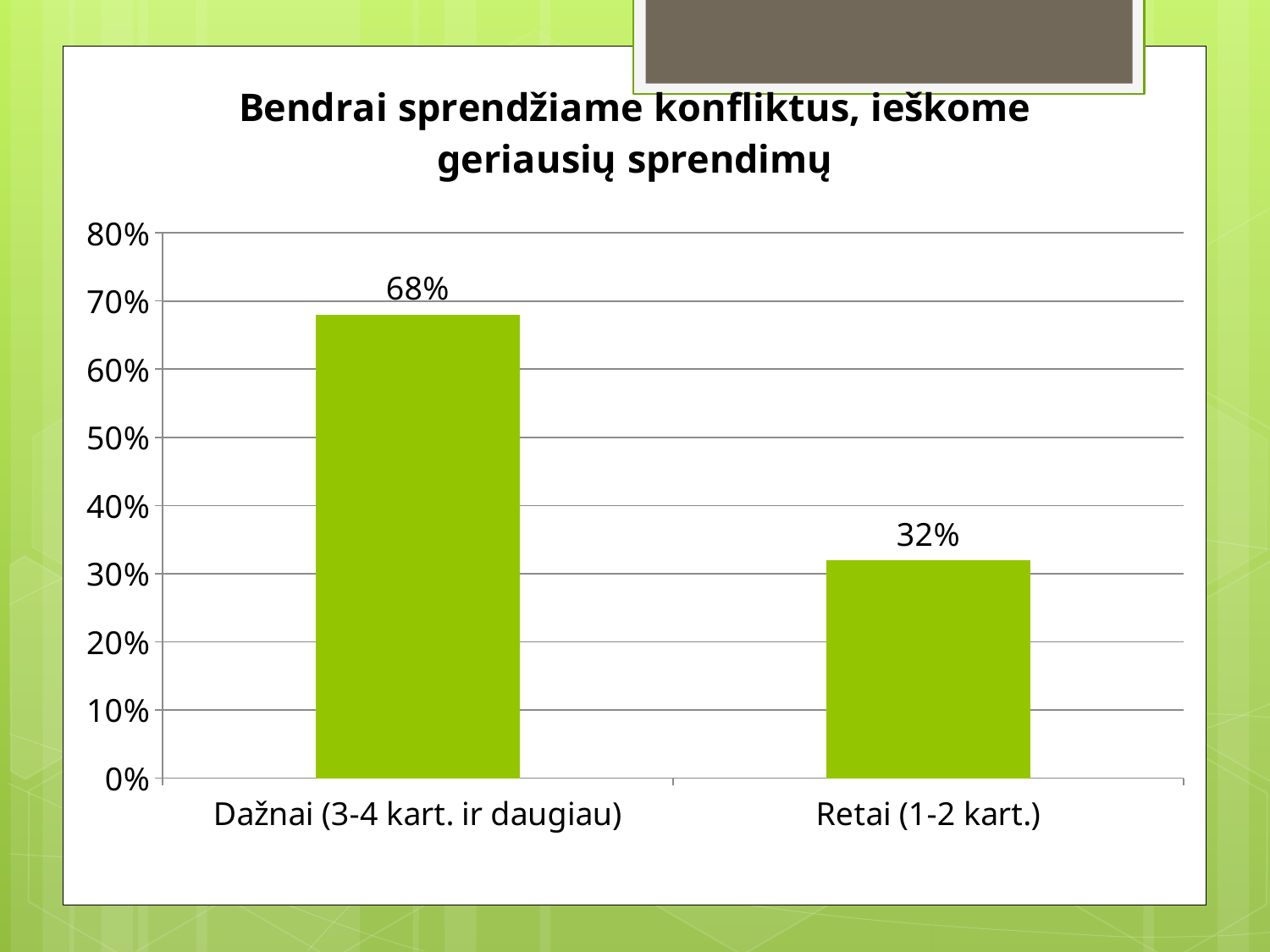
Is the value for "Retai (1-2 kart.)" greater or less than 40%? less Is the value for "Dažnai (3-4 kart. ir daugiau)" greater or less than 60%? greater What kind of chart is shown on the slide? Bar chart Which category has the lowest value? Retai (1-2 kart.) Which is larger: the value for "Dažnai (3-4 kart. ir daugiau)" or for "Retai (1-2 kart.)"? Dažnai (3-4 kart. ir daugiau) How many categories are shown on the chart? 2 What is the value for "Retai (1-2 kart.)"? 32% What is the difference between the values for "Dažnai (3-4 kart. ir daugiau)" and "Retai (1-2 kart.)"? 36% What is the highest value shown on the vertical axis? 80% What is the value for "Dažnai (3-4 kart. ir daugiau)"? 68% What is the title of the chart? Bendrai sprendžiame konfliktus, ieškome geriausių sprendimų Which category has the highest value? Dažnai (3-4 kart. ir daugiau)